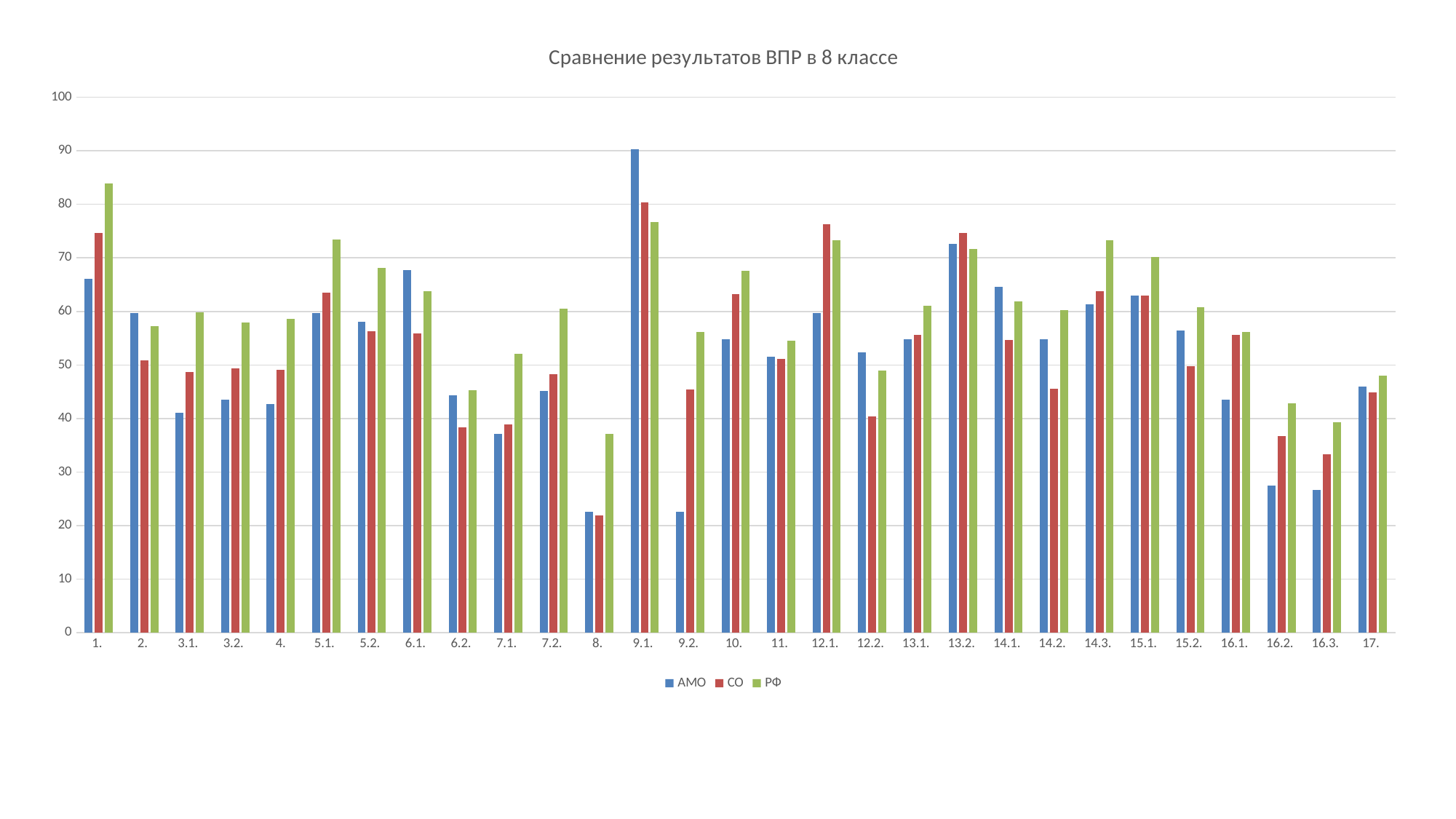
Is the РФ value for 8. greater or less than 40? less What kind of chart is shown on the slide? bar chart For which category is the РФ value highest? 1. For which category is the АМО value highest? 9.1. For which category is the СО value lowest? 8. For which category is the РФ value lowest? 8. Is the АМО value for 16.2. greater or less than 30? less How many categories are shown along the x axis? 29 Is the АМО value for 9.1. greater or less than 80? greater For category 12.1., which is larger: the АМО value or the СО value? СО What is the title of the chart? Сравнение результатов ВПР в 8 классе How many series does the legend list? 3